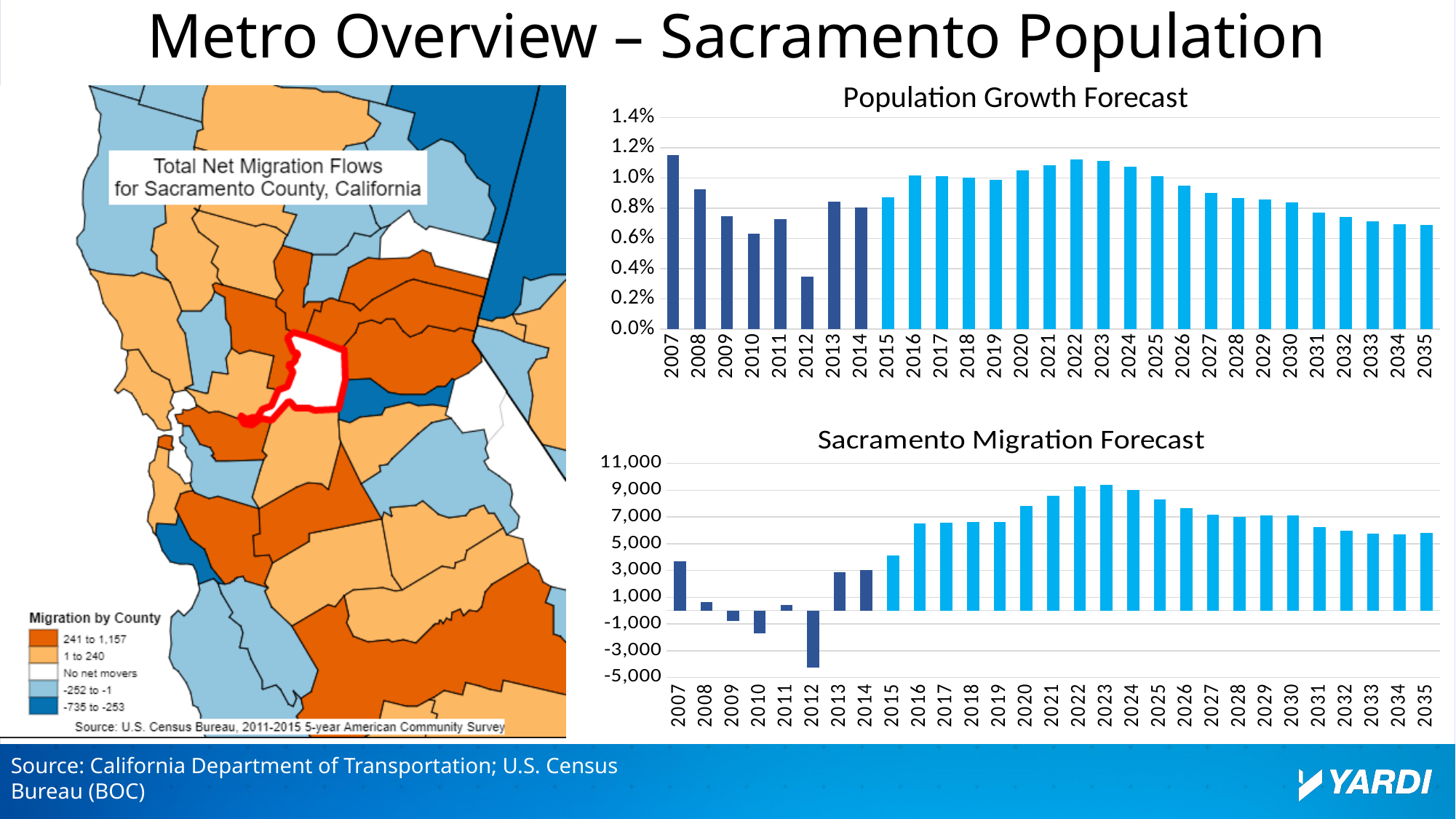
In the Population Growth Forecast chart, which year has the lowest value? 2012 What kind of chart is the Population Growth Forecast chart? bar chart In the Sacramento Migration Forecast chart, is the value for 2035 greater or less than 5,000? greater What is the title of the top chart on the slide? Population Growth Forecast In the Sacramento Migration Forecast chart, which year has the lowest value? 2012 In the Population Growth Forecast chart, is the value for 2035 greater or less than 0.8%? less In the Population Growth Forecast chart, do the values rise or fall from 2022 to 2035? fall How many years are shown on the x axis of the Sacramento Migration Forecast chart? 29 In the Sacramento Migration Forecast chart, is the value for 2012 greater or less than -3,000? less In the Sacramento Migration Forecast chart, which is larger, the value for 2016 or the value for 2021? 2021